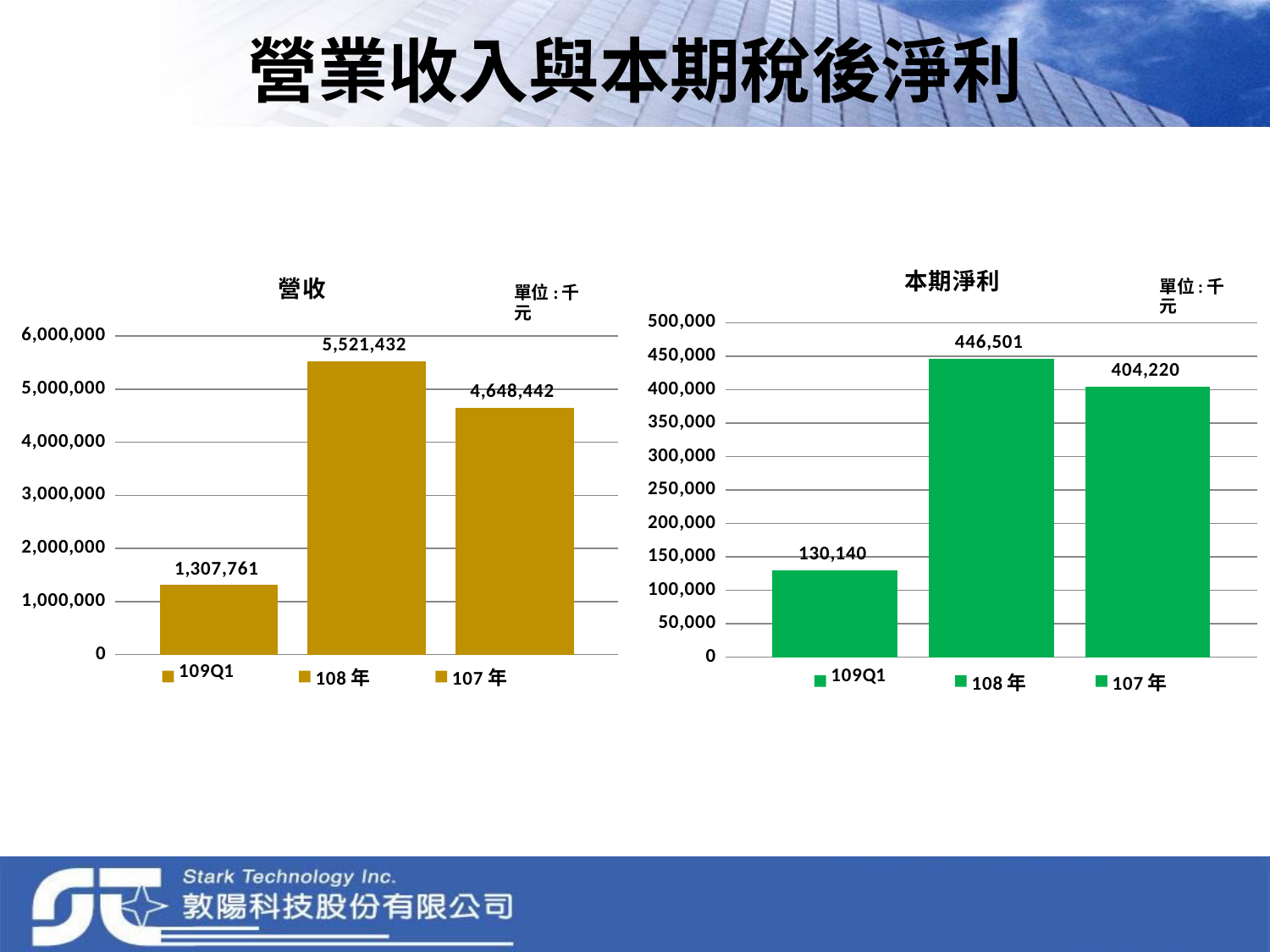
In the 營收 chart, is the value for 107 年 greater or less than 4,000,000? greater In the 本期淨利 chart, what is the value for 107 年? 404,220 In the 營收 chart, what is the difference between the values for 108 年 and 107 年? 872,990 In the 本期淨利 chart, what is the value for 109Q1? 130,140 In the 本期淨利 chart, which is larger, the value for 108 年 or 107 年? 108 年 In the 本期淨利 chart, what is the difference between the values for 108 年 and 107 年? 42,281 In the 本期淨利 chart, which category has the lowest value? 109Q1 In the 營收 chart, what is the value for 108 年? 5,521,432 In the 營收 chart, what is the value for 109Q1? 1,307,761 What kind of chart is the 營收 chart? bar chart How many categories are shown in the 本期淨利 chart? 3 In the 營收 chart, which category has the highest value? 108 年